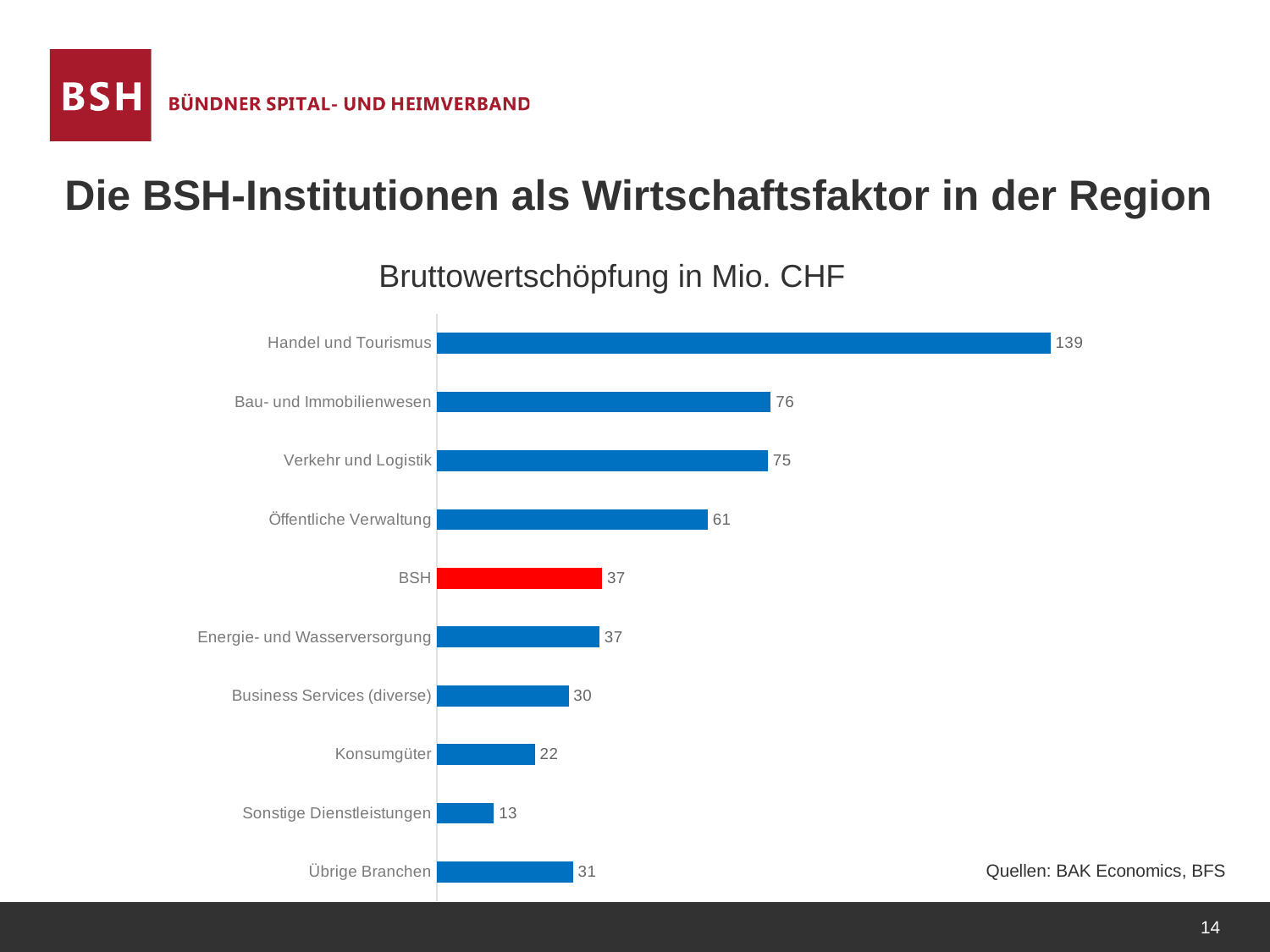
Which category has the highest Bruttowertschöpfung? Handel und Tourismus Which is larger, Konsumgüter or Übrige Branchen? Übrige Branchen What is the Bruttowertschöpfung value for Handel und Tourismus? 139 What is the value shown for BSH? 37 Which category's bar is coloured red instead of blue? BSH What is the value for Sonstige Dienstleistungen? 13 Which category has the lowest Bruttowertschöpfung? Sonstige Dienstleistungen What kind of chart is shown on the slide? Bar chart What is the title of the chart? Bruttowertschöpfung in Mio. CHF What is the difference between Öffentliche Verwaltung and BSH? 24 What is the difference between Handel und Tourismus and Bau- und Immobilienwesen? 63 How many categories are shown in the chart? 10